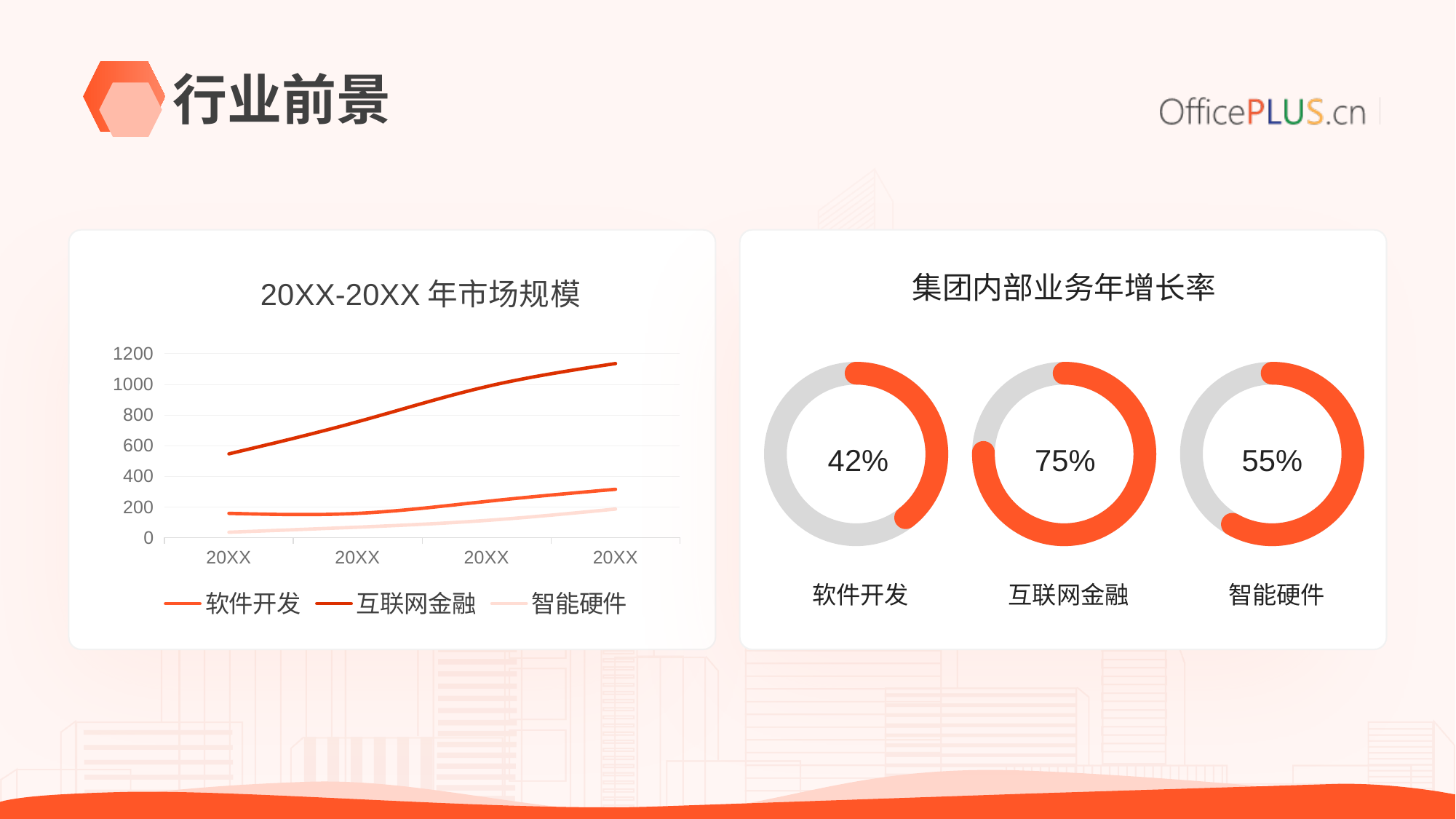
In the chart titled 20XX-20XX 年市场规模, does the 互联网金融 line rise or fall from left to right? rise What kind of chart is the chart titled 20XX-20XX 年市场规模? line chart In the chart titled 集团内部业务年增长率, which business has the highest growth rate? 互联网金融 In the chart titled 集团内部业务年增长率, what is the value for 软件开发? 42% In the chart titled 20XX-20XX 年市场规模, how many points are plotted along the x axis for each series? 4 In the chart titled 20XX-20XX 年市场规模, which series has the highest values throughout? 互联网金融 In the chart titled 20XX-20XX 年市场规模, is the last value of 互联网金融 greater or less than 1000? greater In the chart titled 20XX-20XX 年市场规模, is the last value of 软件开发 greater or less than 200? greater In the chart titled 集团内部业务年增长率, what is the value for 智能硬件? 55% In the chart titled 集团内部业务年增长率, what is the difference between the values for 互联网金融 and 软件开发? 33% In the chart titled 20XX-20XX 年市场规模, is the first value of 互联网金融 greater or less than 400? greater In the chart titled 20XX-20XX 年市场规模, how many series does the legend list? 3